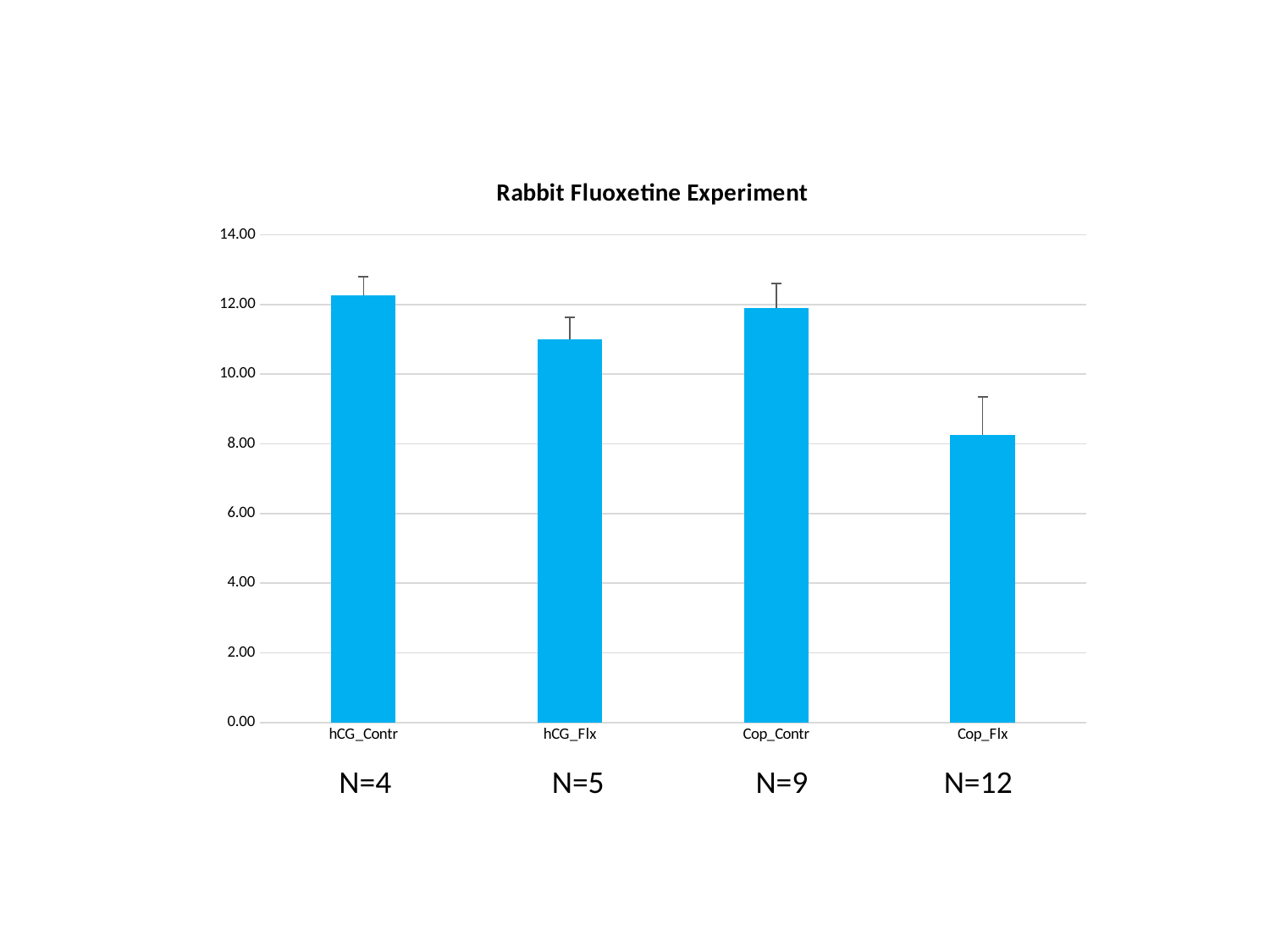
Which is larger, the value for hCG_Flx or the value for Cop_Flx? hCG_Flx What is the title of the chart? Rabbit Fluoxetine Experiment Is the value for Cop_Flx greater or less than 10.00? less Is the value for Cop_Contr greater or less than 10.00? greater Is the value for hCG_Flx greater or less than 10.00? greater Which category has the highest bar? hCG_Contr How many categories are plotted on the x axis? 4 What sample size (N) is shown beneath the Cop_Flx bar? N=12 What kind of chart is shown on the slide? bar chart Which is larger, the value for hCG_Contr or the value for hCG_Flx? hCG_Contr Which category has the lowest bar? Cop_Flx